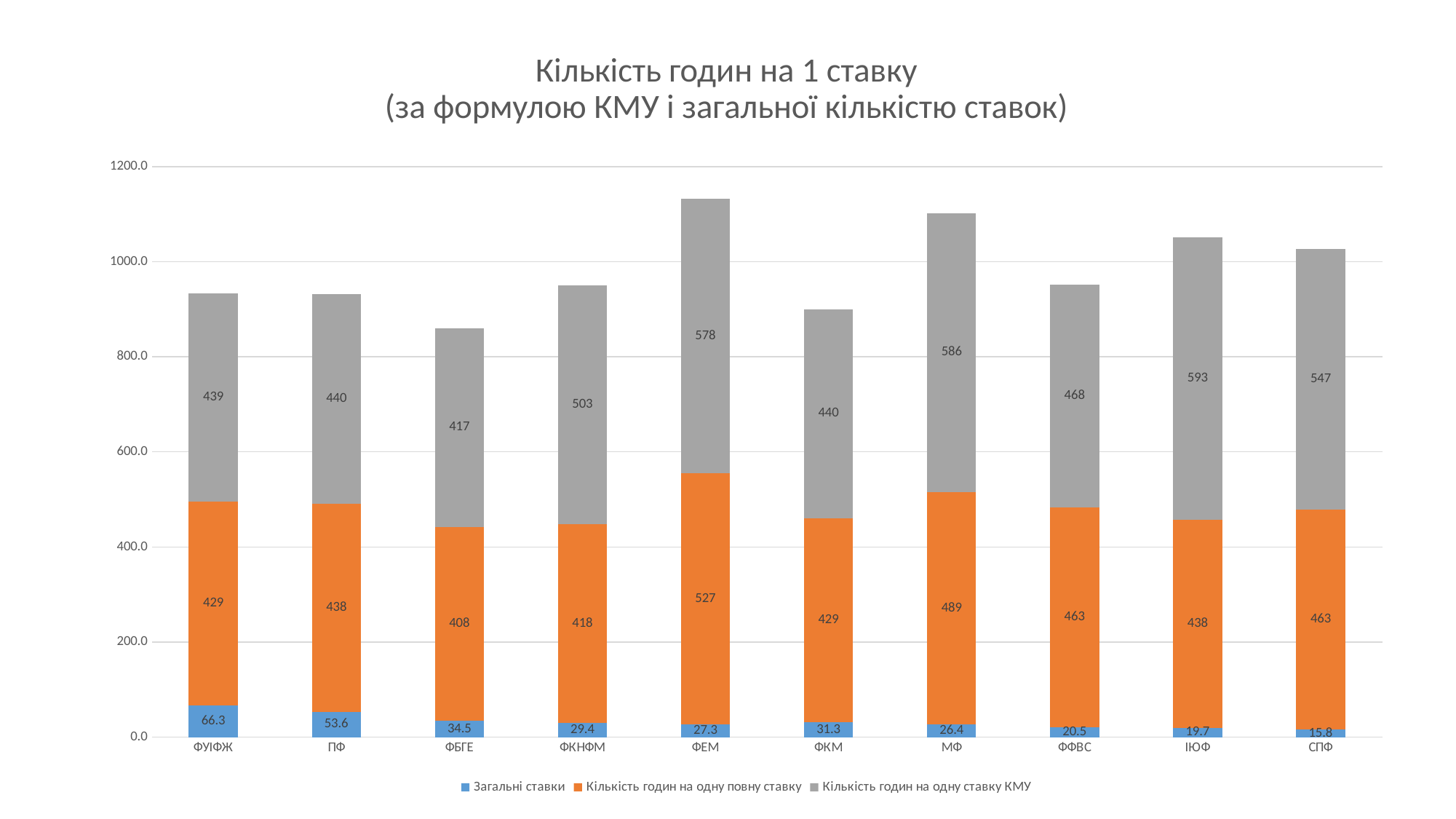
What is the total of the stacked bar for ФЕМ? 1132.3 Which is larger: Кількість годин на одну повну ставку for ФЕМ or for ФФВС? ФЕМ Which category has the lowest value for Загальні ставки? СПФ What is the value of Кількість годин на одну повну ставку for МФ? 489 Which category has the highest value for Кількість годин на одну ставку КМУ? ІЮФ What is the value of Кількість годин на одну ставку КМУ for ФЕМ? 578 How many series does the legend list? 3 What is the value of Загальні ставки for ФУІФЖ? 66.3 What kind of chart is shown on the slide? Stacked bar chart How many categories are shown on the x axis? 10 Do the values for Загальні ставки rise or fall from left to right along the x axis? Fall What is the difference between the Кількість годин на одну ставку КМУ values for ІЮФ and ФБГЕ? 176